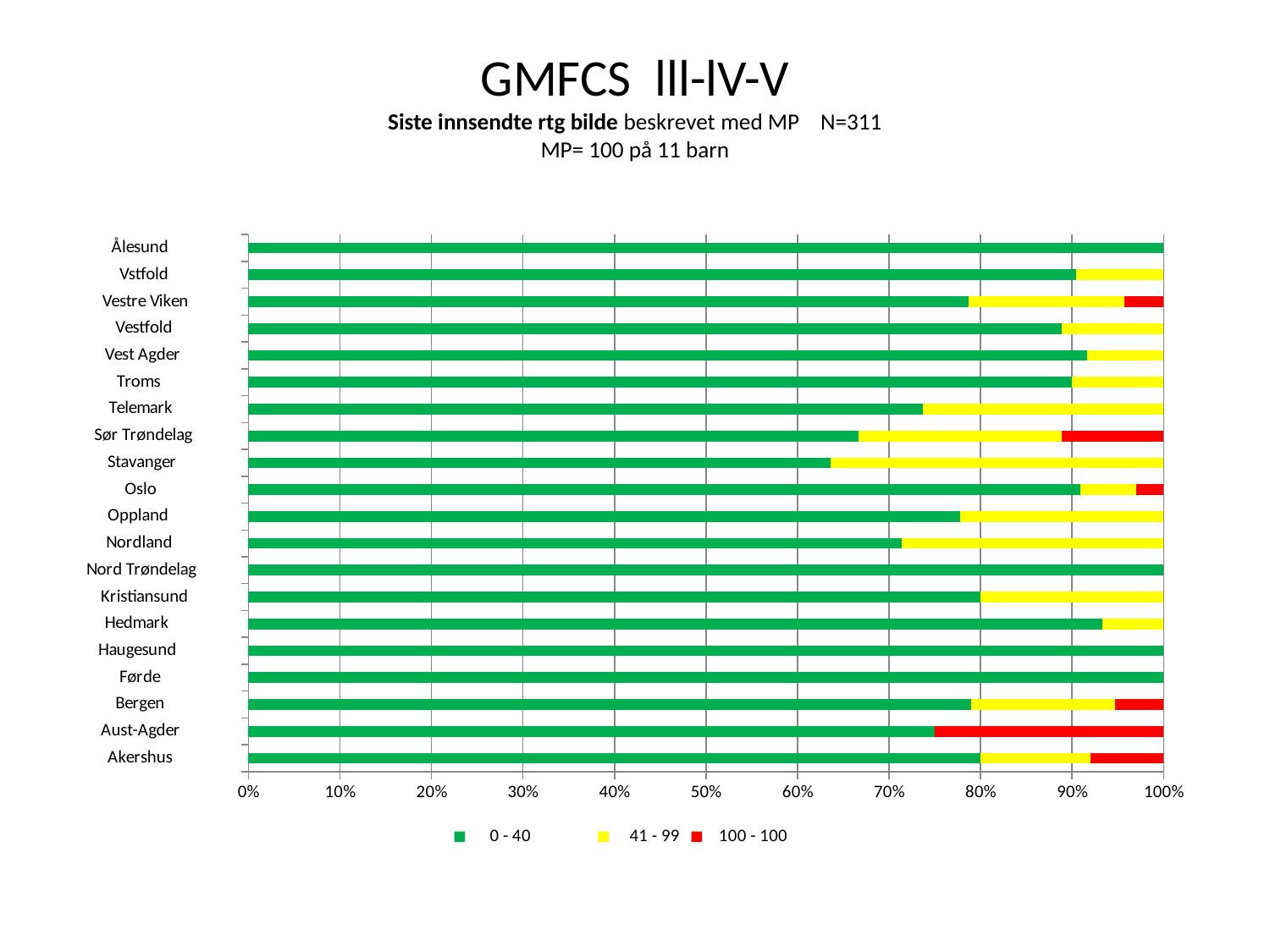
Is the 0 - 40 value for Stavanger greater or less than 70%? less How many series does the legend list? 3 What are the three series named in the legend? 0 - 40, 41 - 99, 100 - 100 What is the value of the 0 - 40 series for Førde? 100% Is the 0 - 40 value for Telemark greater or less than 70%? greater What kind of chart is shown on the slide? Bar chart Which has the larger 0 - 40 value, Stavanger or Sør Trøndelag? Sør Trøndelag How many categories (regions) are plotted on the chart? 20 What is the value of the 0 - 40 series for Ålesund? 100% Which colour represents the 100 - 100 series? Red Is the 100 - 100 value for Aust-Agder greater or less than 20%? greater Which region has the largest 100 - 100 (red) segment? Aust-Agder